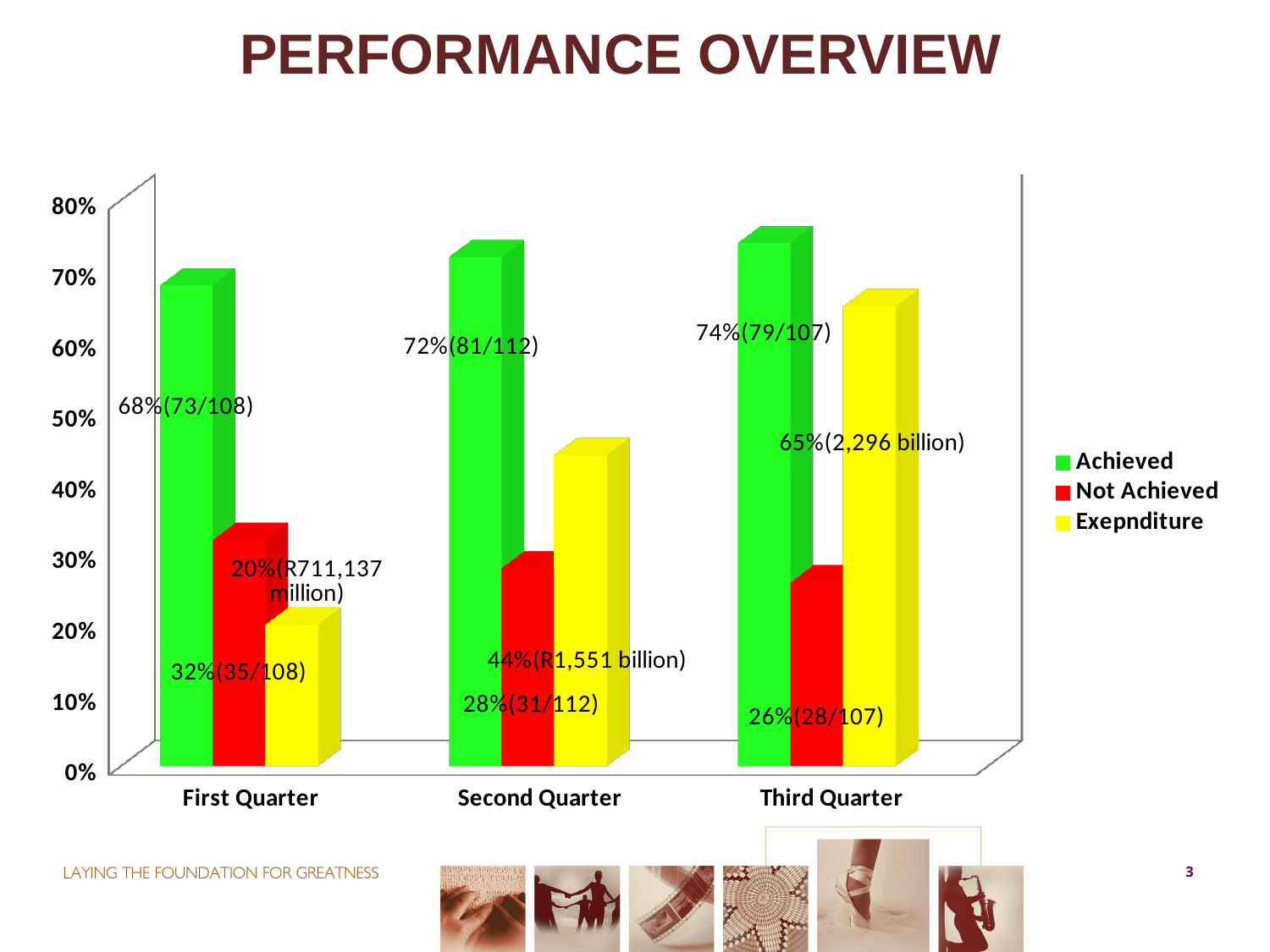
In which quarter is the Achieved percentage highest? Third Quarter By how many percentage points does the Achieved value in the Third Quarter exceed the Achieved value in the First Quarter? 6 percentage points How many quarters are shown on the x axis? 3 What is the Not Achieved value for the Third Quarter? 26%(28/107) What is the Expenditure value for the First Quarter? 20%(R711,137 million) What is the Expenditure value for the Second Quarter? 44%(R1,551 billion) How many series does the legend list? 3 Is the Not Achieved value for the First Quarter greater or less than 40%? less What is the Achieved value for the First Quarter? 68%(73/108) Does the Not Achieved percentage rise or fall from the First Quarter to the Third Quarter? fall In the Second Quarter, which is larger: Not Achieved or Expenditure? Expenditure In which quarter is the Expenditure percentage lowest? First Quarter